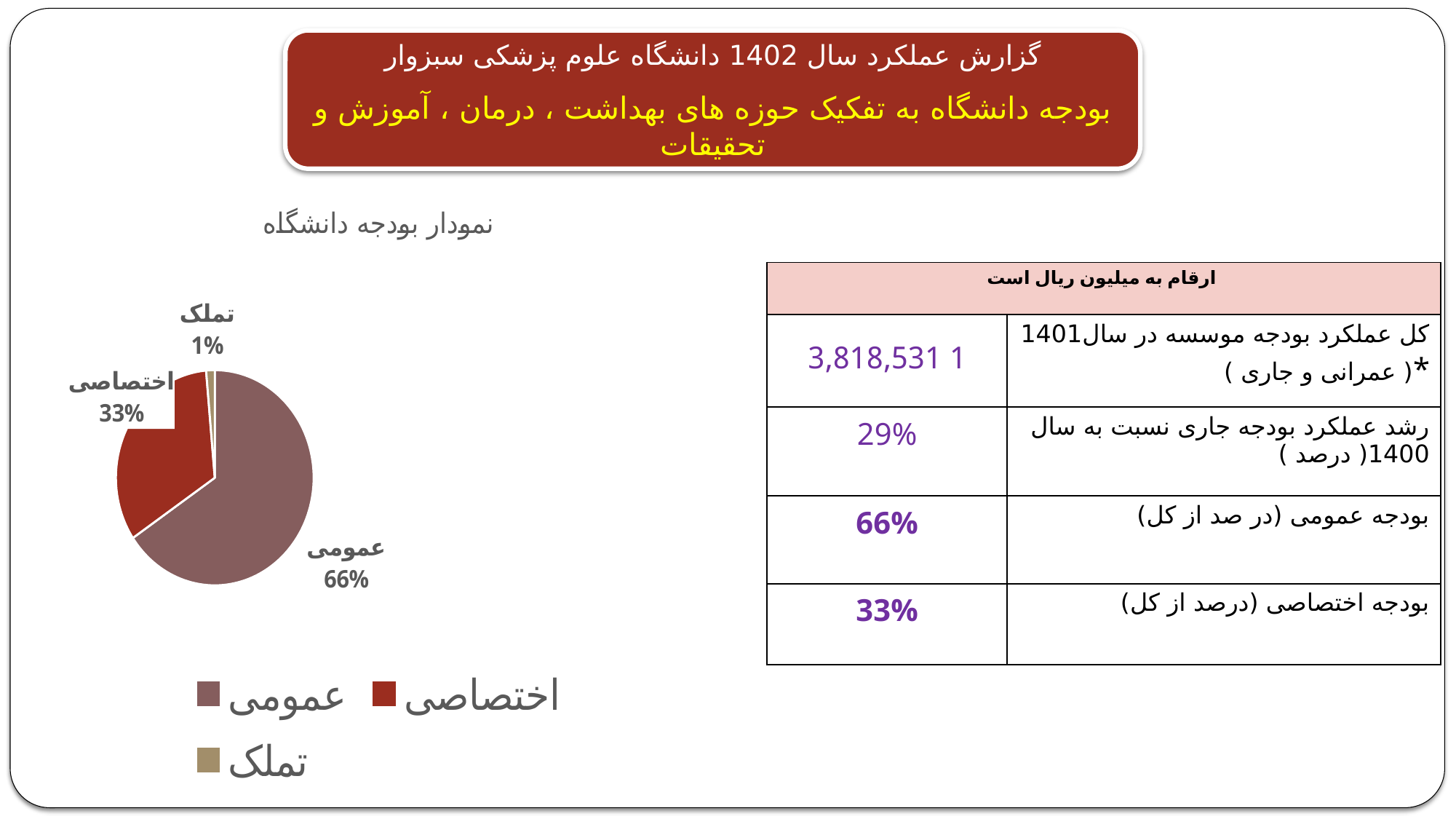
What kind of chart is shown on the slide? pie chart Which slice of the pie chart is the smallest? تملک What share of the pie does the عمومی slice represent? 66% Which is larger, the اختصاصی slice or the تملک slice? اختصاصی What share of the pie does the تملک slice represent? 1% What share of the pie does the اختصاصی slice represent? 33% What is the title of the chart on the slide? نمودار بودجه دانشگاه How many slices does the pie chart have? 3 How many entries does the chart legend list? 3 Which slice of the pie chart is the largest? عمومی What is the difference in percentage points between the اختصاصی and تملک slices? 32 What is the difference in percentage points between the عمومی and اختصاصی slices? 33